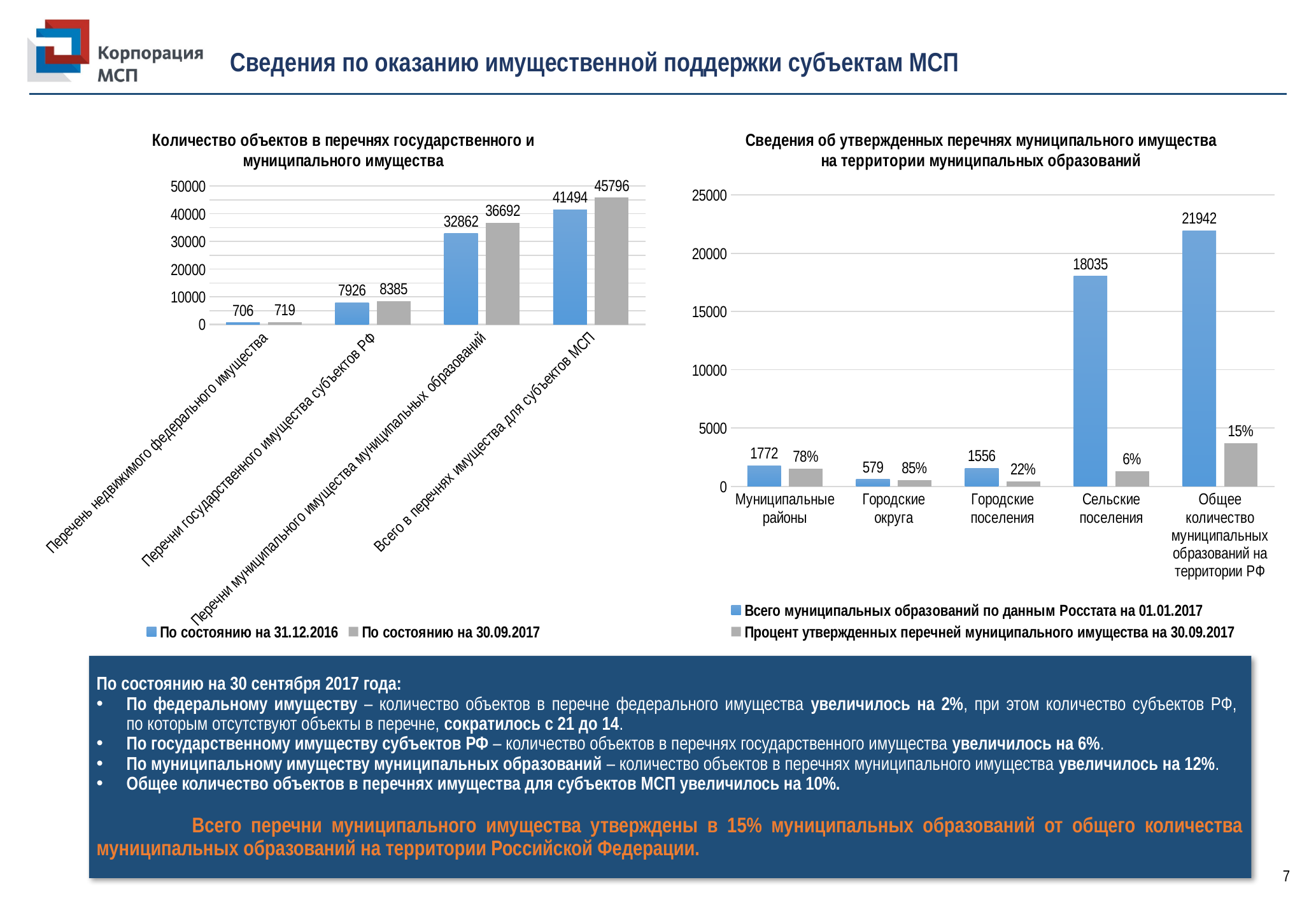
In the left chart 'Количество объектов в перечнях государственного и муниципального имущества', how many categories are shown on the x axis? 4 In the right chart 'Сведения об утвержденных перечнях муниципального имущества на территории муниципальных образований', what is the percentage of approved lists for 'Городские округа'? 85% In the left chart 'Количество объектов в перечнях государственного и муниципального имущества', what is the value for 'Перечни государственного имущества субъектов РФ' as of 30.09.2017? 8385 In the left chart 'Количество объектов в перечнях государственного и муниципального имущества', what is the difference between the 30.09.2017 and 31.12.2016 values for 'Перечни муниципального имущества муниципальных образований'? 3830 In the left chart 'Количество объектов в перечнях государственного и муниципального имущества', which category has the highest value as of 30.09.2017? Всего в перечнях имущества для субъектов МСП In the right chart 'Сведения об утвержденных перечнях муниципального имущества на территории муниципальных образований', is the value for 'Общее количество муниципальных образований на территории РФ' (blue series) greater or less than 20000? greater In the right chart 'Сведения об утвержденных перечнях муниципального имущества на территории муниципальных образований', which is larger: the number of municipal entities for 'Муниципальные районы' or for 'Городские поселения'? Муниципальные районы In the right chart 'Сведения об утвержденных перечнях муниципального имущества на территории муниципальных образований', what is the number of municipal entities for 'Сельские поселения'? 18035 In the left chart 'Количество объектов в перечнях государственного и муниципального имущества', what is the value for 'Перечень недвижимого федерального имущества' as of 31.12.2016? 706 What type of chart is the right chart 'Сведения об утвержденных перечнях муниципального имущества на территории муниципальных образований'? Bar chart In the right chart 'Сведения об утвержденных перечнях муниципального имущества на территории муниципальных образований', which category has the lowest number of municipal entities (blue series)? Городские округа In the left chart 'Количество объектов в перечнях государственного и муниципального имущества', how many series does the legend list? 2